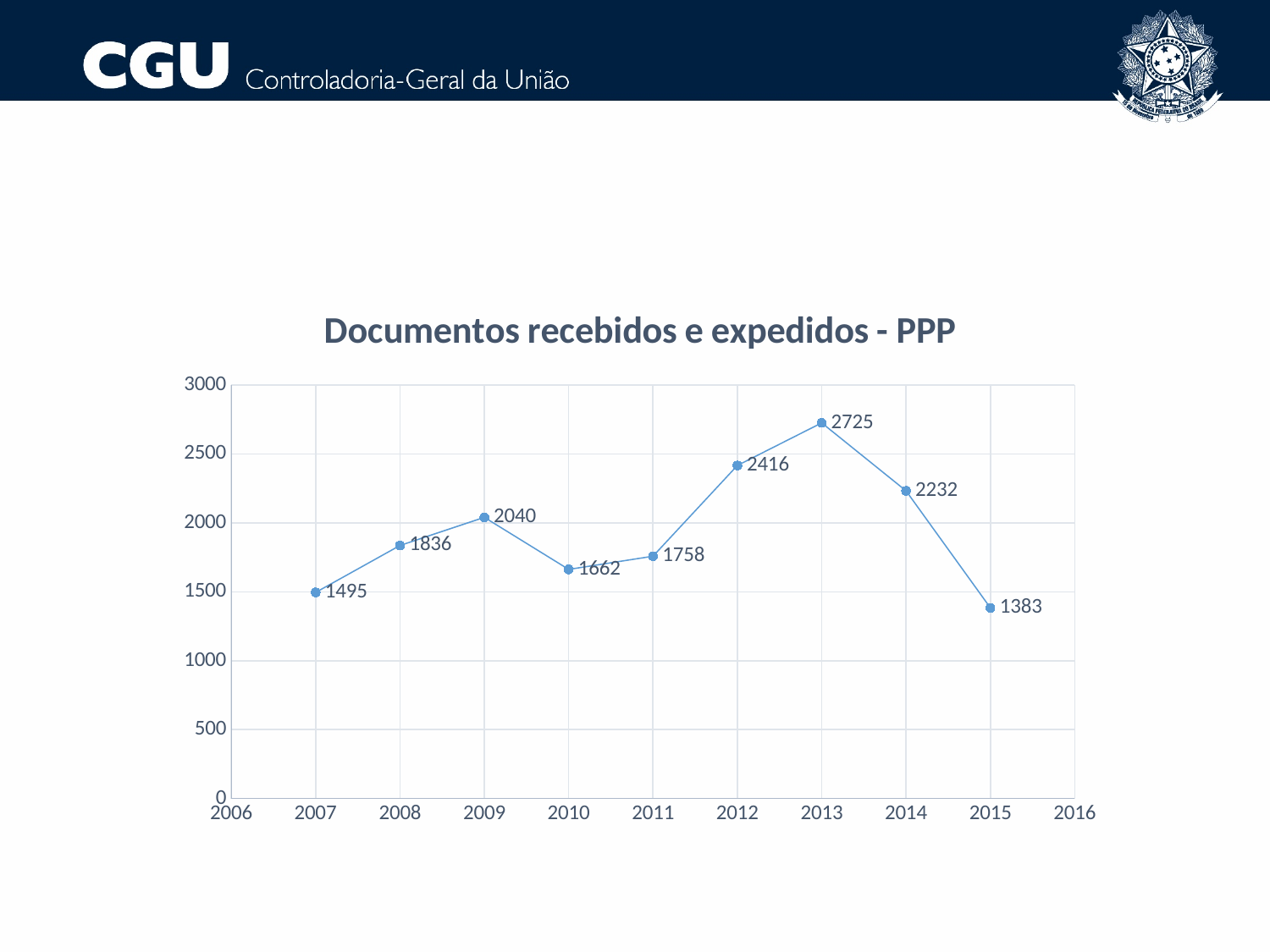
What is the difference between the values for 2013 and 2014? 493 Which year has the highest value? 2013 What kind of chart is shown? line chart Which year has the lowest value? 2015 What is the value for 2007? 1495 Is the value for 2012 greater or less than 2500? less How many data points are plotted on the chart? 9 What is the value for 2013? 2725 What is the title of the chart? Documentos recebidos e expedidos - PPP What is the value for 2010? 1662 What is the difference between the values for 2009 and 2010? 378 Which is larger, the value for 2008 or the value for 2011? 2008